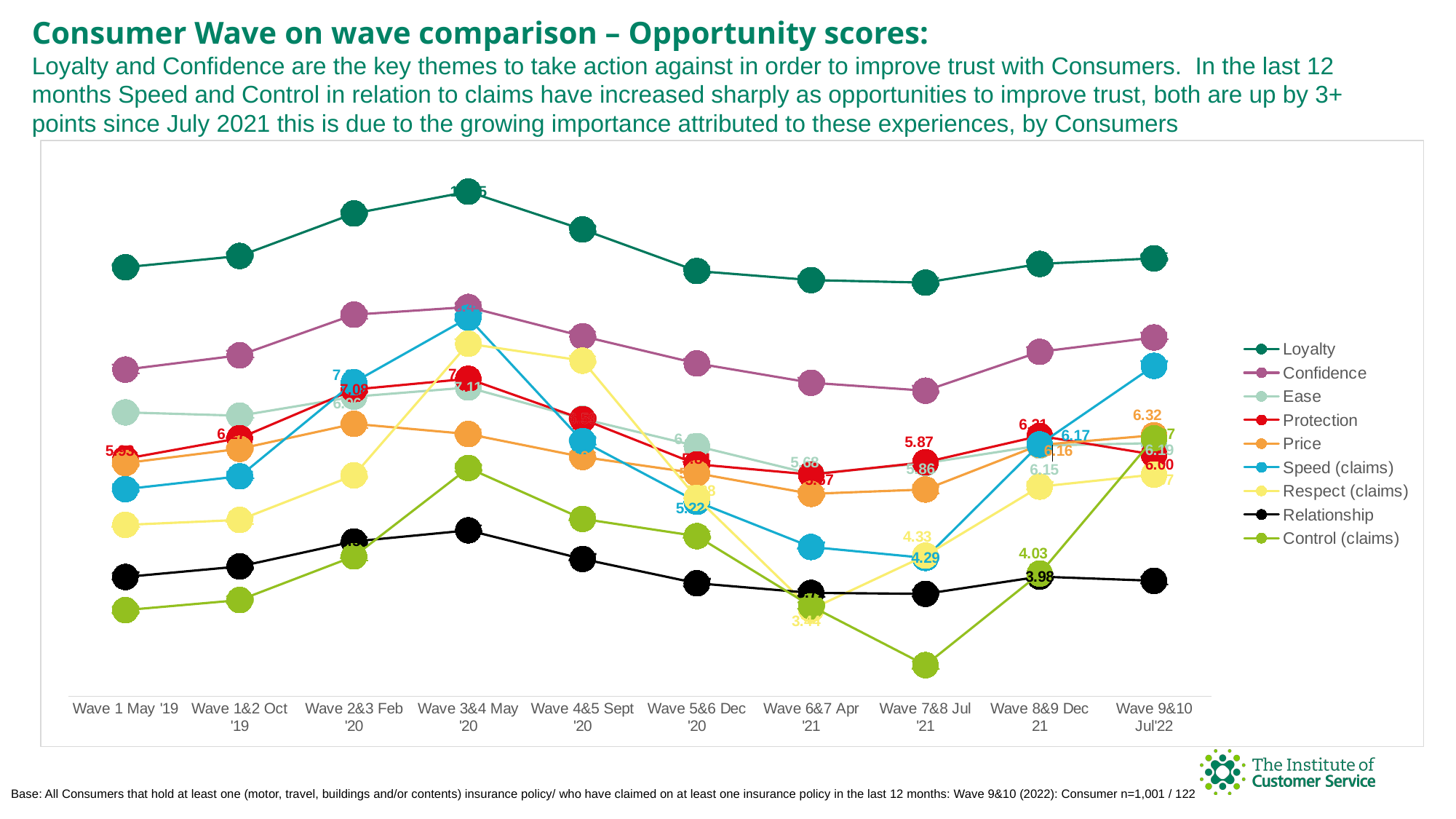
What is the Protection score at Wave 7&8 Jul '21? 5.87 What is the difference between the Control (claims) score and the Relationship score at Wave 8&9 Dec 21? 0.05 What kind of chart is shown on the slide? line chart How many waves (x-axis categories) are plotted on the chart? 10 What is the Price score at Wave 9&10 Jul'22? 6.32 Which series has the highest score across all waves? Loyalty What is the Relationship score at Wave 8&9 Dec 21? 3.98 How many series does the legend list? 9 At which wave does Control (claims) reach its lowest point? Wave 7&8 Jul '21 What is the Control (claims) score at Wave 8&9 Dec 21? 4.03